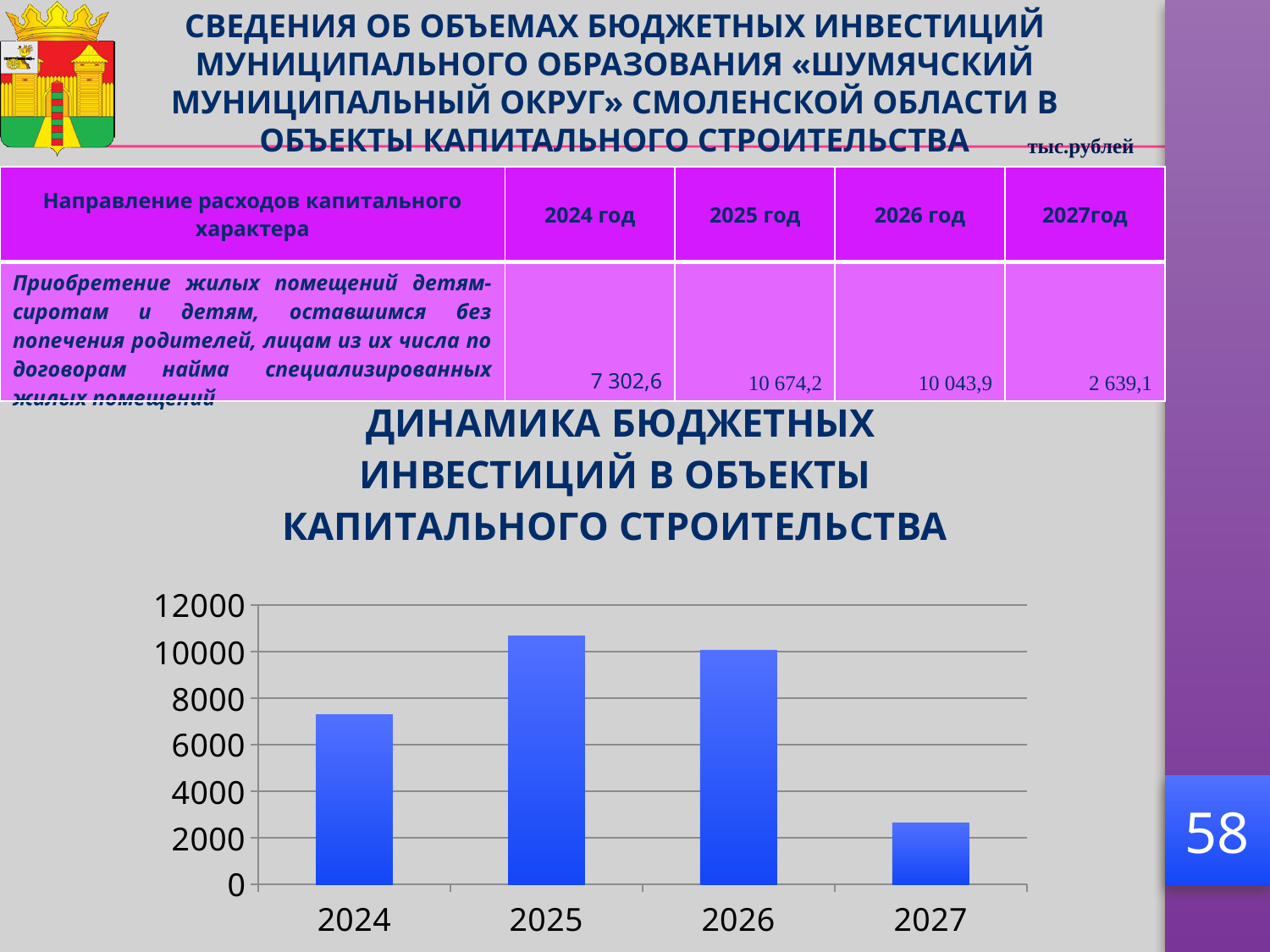
Is the value for 2027 greater or less than 4000? less Is the value for 2024 greater or less than 8000? less Is the value for 2025 greater or less than 10000? greater Which year has the lowest bar on the chart? 2027 Which is larger, the value for 2024 or the value for 2026? 2026 What kind of chart is shown on the slide? bar chart Which year has the highest bar on the chart? 2025 Do the values rise or fall from 2025 to 2027 on the chart? fall According to the table on the slide, what is the value for 2025 (thousand rubles)? 10 674,2 According to the table on the slide, what is the value for 2027 (thousand rubles)? 2 639,1 How many years (bars) are shown on the chart? 4